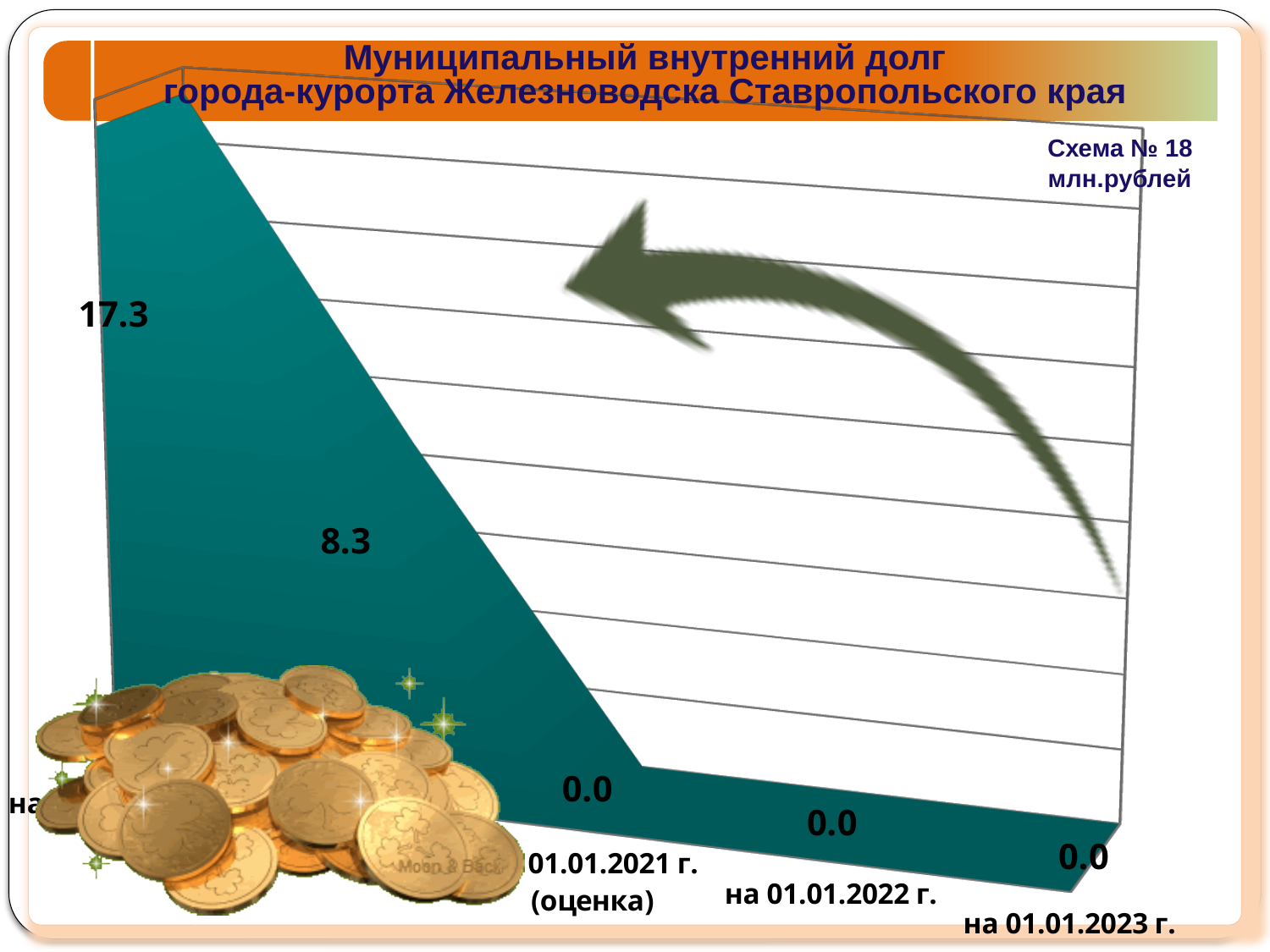
How many data points are plotted on the chart? 5 What is the value for на 01.01.2022 г.? 0.0 What is the highest value shown on the chart? 17.3 What is the value of the second data point from the left? 8.3 Which is larger: the first data point or the second data point? the first data point What is the value for 01.01.2021 г. (оценка)? 0.0 What is the title of the chart? Муниципальный внутренний долг города-курорта Железноводска Ставропольского края What kind of chart is shown on the slide? area chart In what units are the chart values given? млн.рублей What is the difference between the first data point (17.3) and the second data point (8.3)? 10.0 What is the value for на 01.01.2023 г.? 0.0 Do the values rise or fall from left to right along the x axis? fall